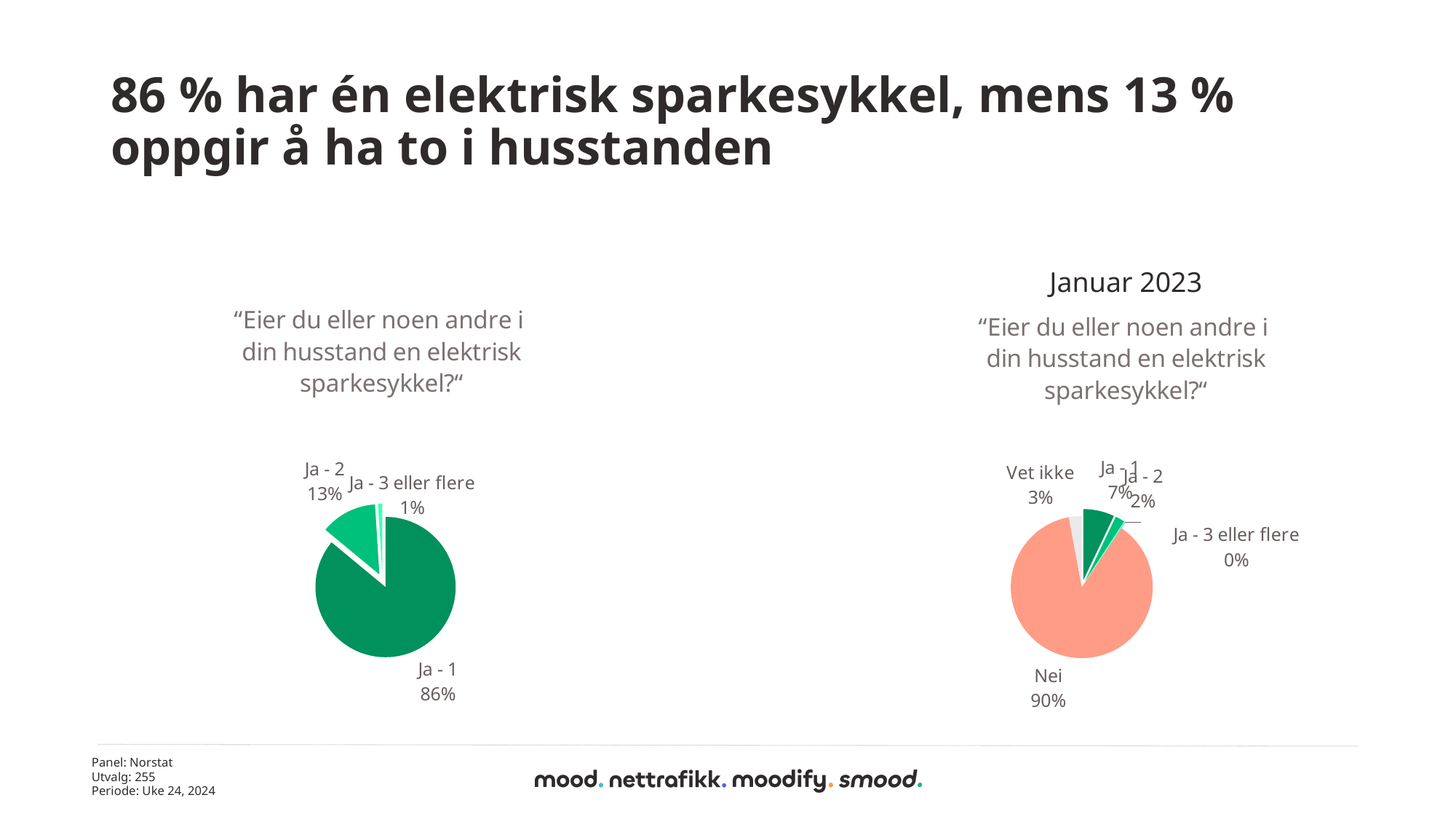
On the left pie chart, what is the difference in percentage points between "Ja - 1" and "Ja - 2"? 73 On the left pie chart, what share is labelled for "Ja - 1"? 86% On the right pie chart (Januar 2023), which category has the largest slice? Nei On the left pie chart, which category has the largest slice? Ja - 1 On the left pie chart, which category has the smallest slice? Ja - 3 eller flere On the right pie chart (Januar 2023), what share is labelled for "Nei"? 90% On the left pie chart, what share is labelled for "Ja - 2"? 13% How many categories are labelled on the right pie chart (Januar 2023)? 5 What type of chart is shown on the left of the slide? Pie chart On the left pie chart, what share is labelled for "Ja - 3 eller flere"? 1% On the right pie chart (Januar 2023), what share is labelled for "Ja - 1"? 7% On the right pie chart (Januar 2023), what share is labelled for "Vet ikke"? 3%